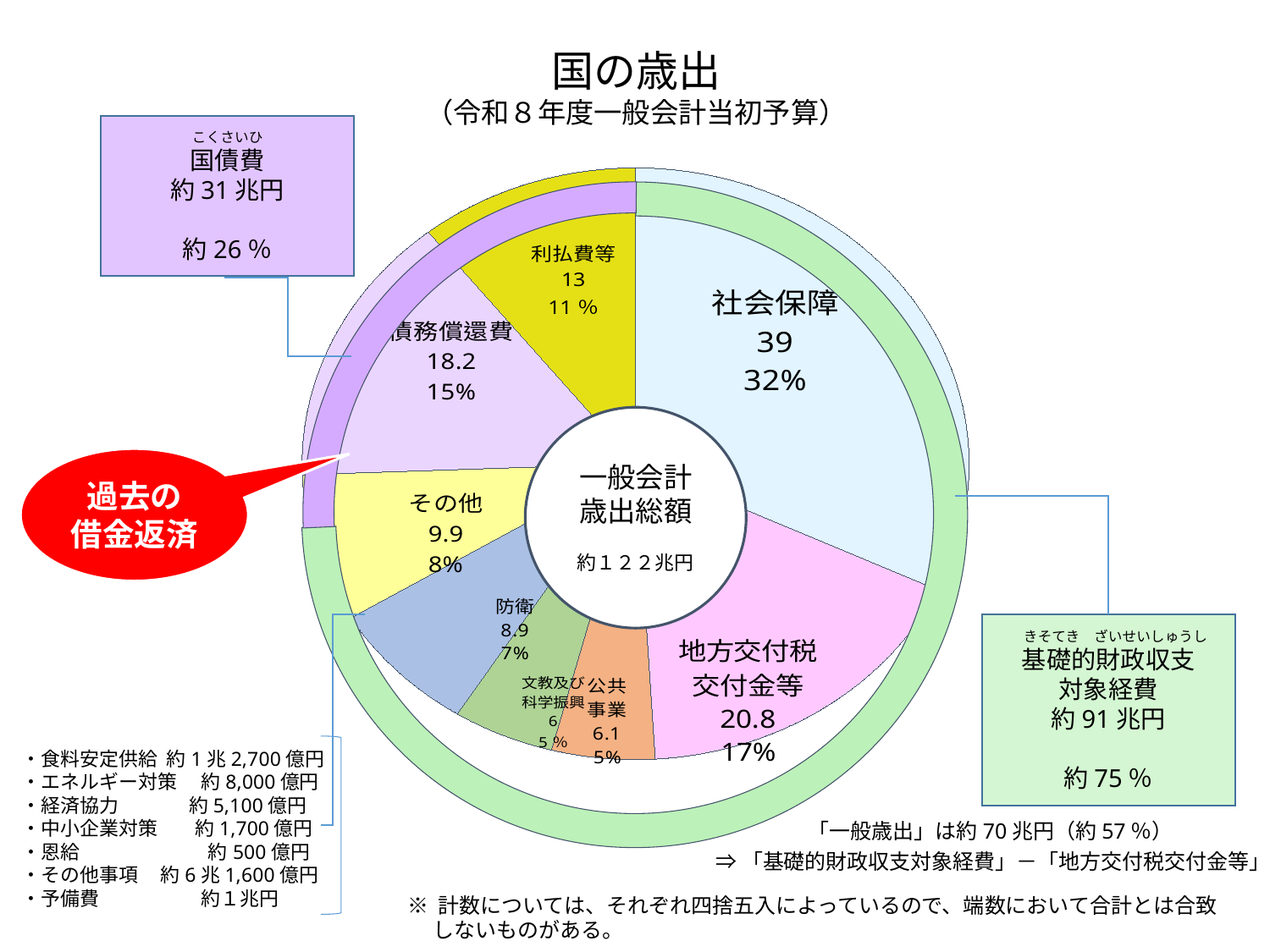
防衛とその他では、どちらの歳出額が大きいですか？ その他 基礎的財政収支対象経費の金額はいくらですか？ 約91兆円 利払費等の割合は何％ですか？ 11％ 社会保障の歳出額はいくらですか？ 39 最も割合が大きい項目はどれですか？ 社会保障 円グラフには項目がいくつありますか？ 8 地方交付税交付金等の割合は何％ですか？ 17% 一般会計歳出総額はいくらですか？ 約１２２兆円 社会保障と地方交付税交付金等の歳出額の差はいくらですか？ 18.2 このグラフはどの種類のグラフですか？ 円グラフ 国債費の割合は何％ですか？ 約26％ 債務償還費の歳出額はいくらですか？ 18.2